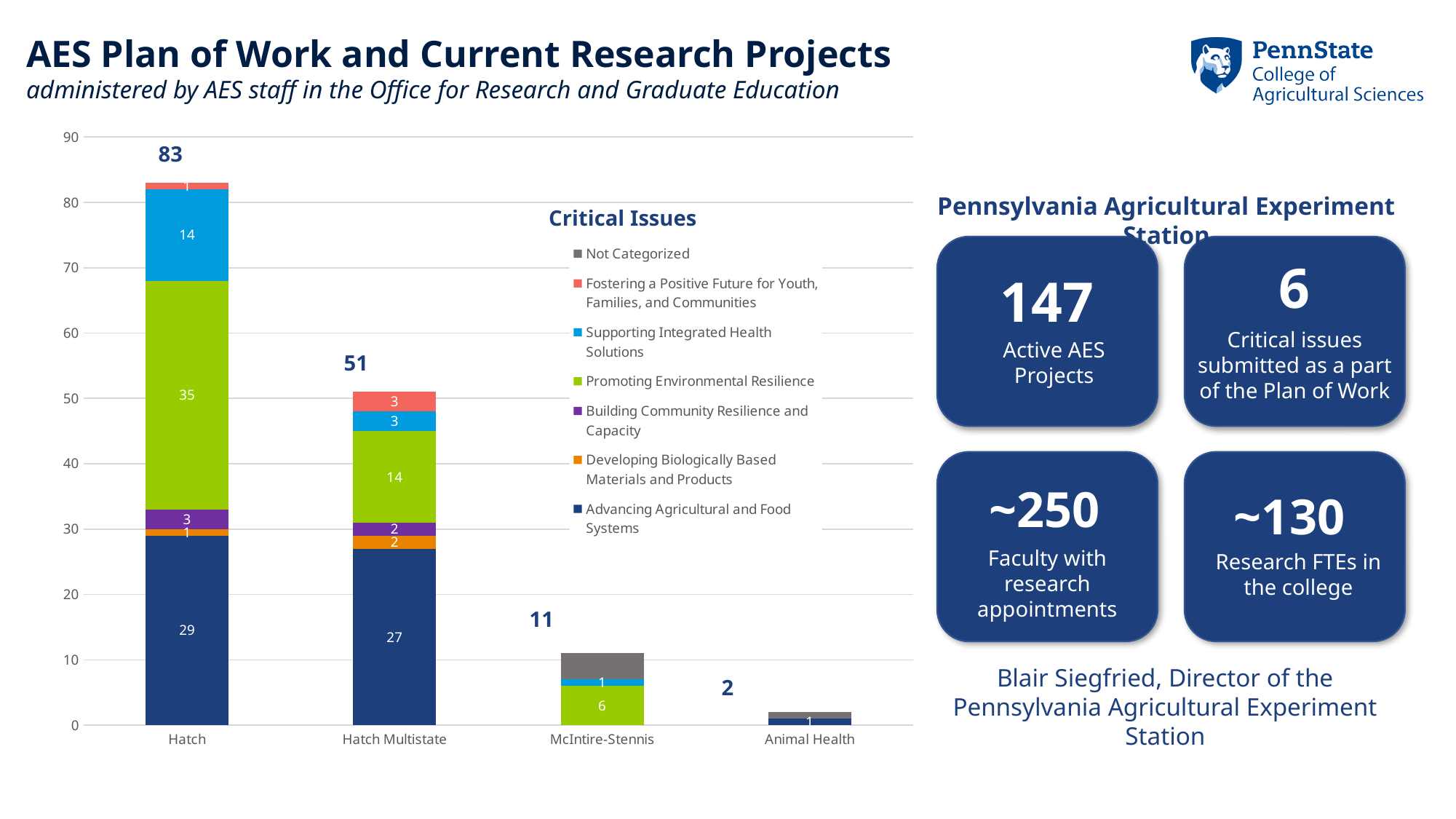
Which category has the lowest total in the chart? Animal Health Which category has the highest total in the chart? Hatch How many categories are shown on the x axis of the chart? 4 What is the total of the stacked bar for Hatch? 83 How many series does the chart's legend list? 7 What is the value for Promoting Environmental Resilience in the McIntire-Stennis bar? 6 What is the difference between the total for Hatch and the total for Hatch Multistate? 32 What is the value for Advancing Agricultural and Food Systems in the Hatch bar? 29 What is the value for Promoting Environmental Resilience in the Hatch Multistate bar? 14 What is the total of the stacked bar for Hatch Multistate? 51 Which has the larger value for Promoting Environmental Resilience, Hatch or Hatch Multistate? Hatch What kind of chart is shown on the slide? Stacked bar chart